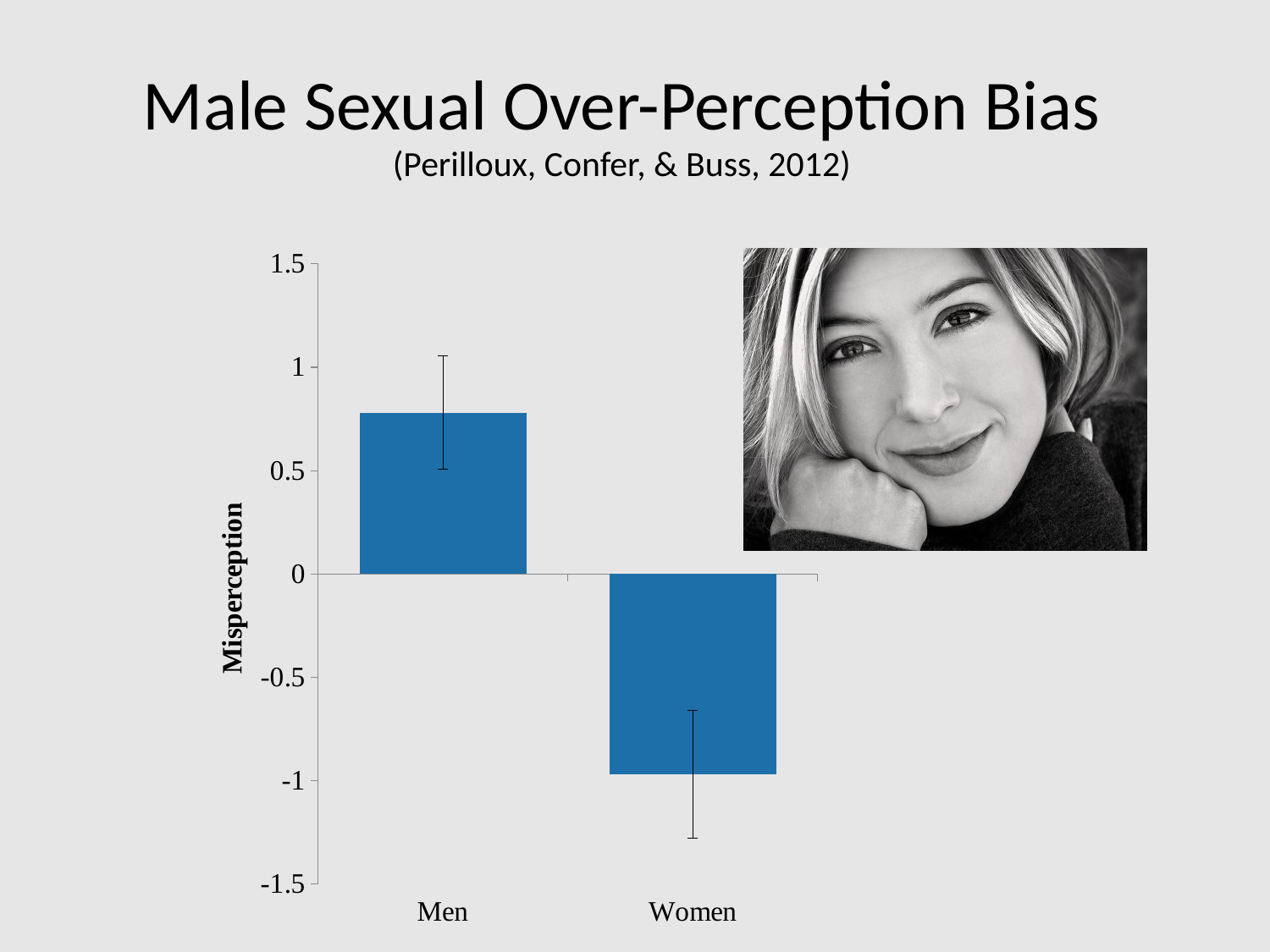
What is the label on the vertical axis of the chart? Misperception Which category has the lowest Misperception value? Women Which category has the highest Misperception value? Men What kind of chart is shown on the slide? bar chart Do the values rise or fall moving from Men to Women along the x axis? fall What is the title of the slide containing the chart? Male Sexual Over-Perception Bias Which is larger, the Misperception value for Men or for Women? Men How many categories are plotted on the x axis of the chart? 2 Is the Misperception value for Men greater or less than 1? less Is the Misperception value for Men greater or less than 0.5? greater Is the Misperception value for Women greater or less than 0? less